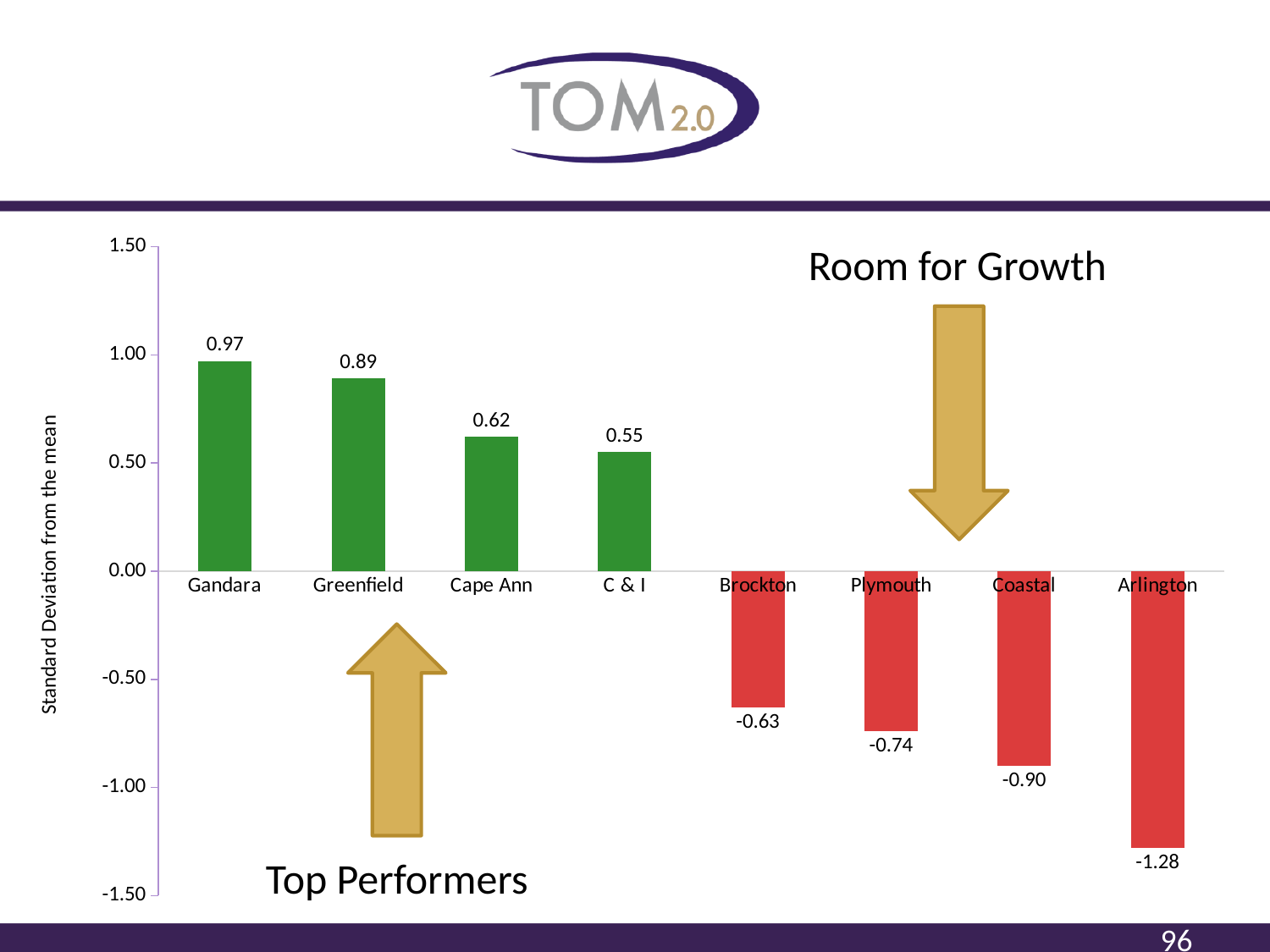
What is the label on the vertical axis? Standard Deviation from the mean Is the value for Coastal greater or less than -0.50? less What is the value for Gandara? 0.97 Which category has the lowest value? Arlington What is the value for Plymouth? -0.74 Which is larger, the value for Cape Ann or the value for C & I? Cape Ann Which category has the highest value? Gandara What kind of chart is shown on the slide? bar chart What is the value for Arlington? -1.28 What is the difference between the values for Gandara and Greenfield? 0.08 How many categories are shown on the x axis? 8 Do the values rise or fall moving from left to right along the x axis? fall